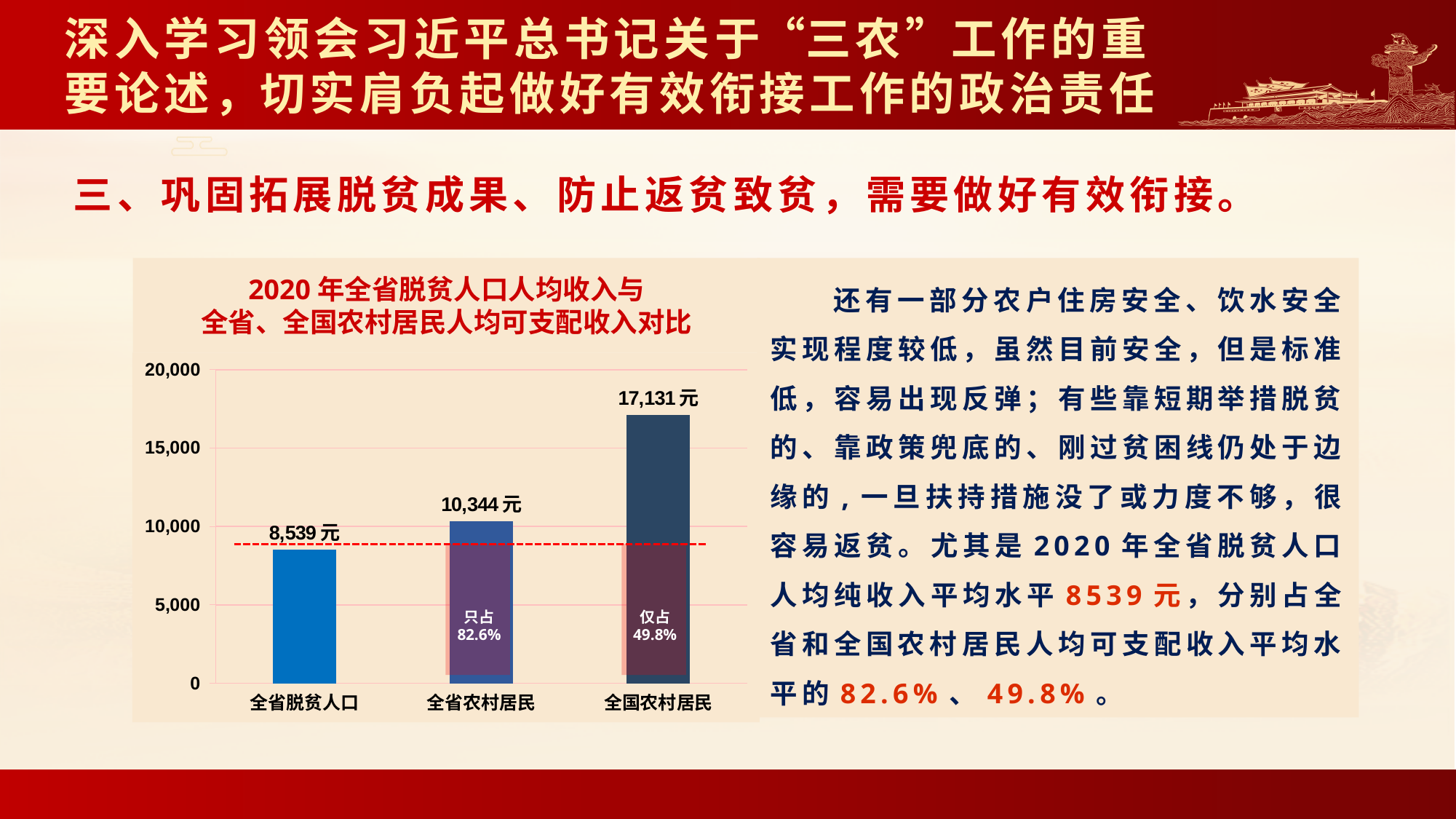
Which category has the lowest value? 全省脱贫人口 What percentage label is printed on the 全国农村居民 bar? 仅占 49.8% Which category has the highest value? 全国农村居民 What is the difference between the values for 全省农村居民 and 全省脱贫人口? 1,805 元 What kind of chart is shown on the slide? bar chart What is the value shown for 全省脱贫人口? 8,539 元 Is the value for 全省脱贫人口 greater or less than 10,000? less What is the difference between the values for 全国农村居民 and 全省脱贫人口? 8,592 元 Which is larger, the value for 全省农村居民 or the value for 全国农村居民? 全国农村居民 How many categories are shown on the x axis? 3 What is the value shown for 全省农村居民? 10,344 元 What is the value shown for 全国农村居民? 17,131 元